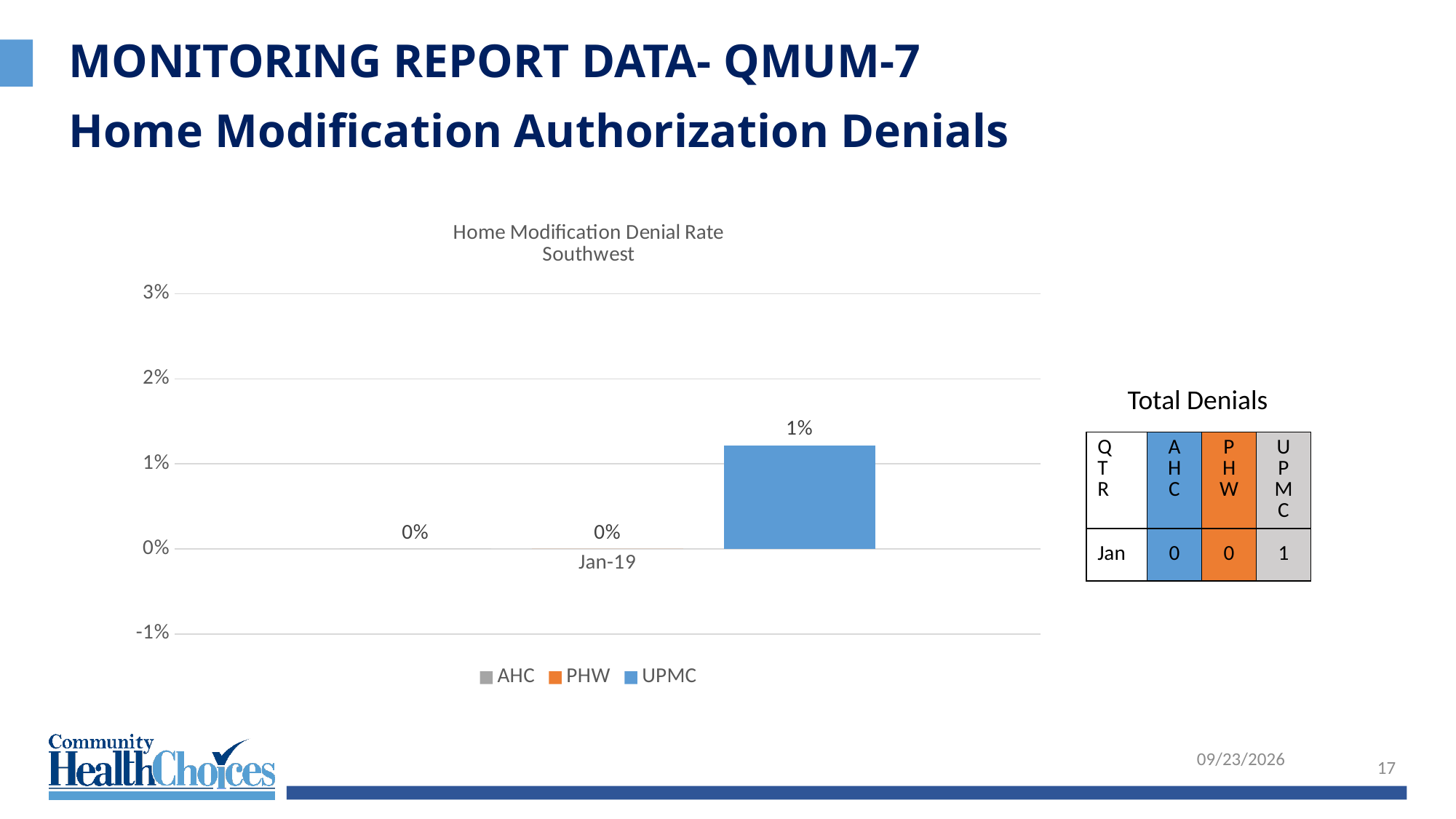
Is the UPMC denial rate for Jan-19 greater or less than 2%? less What is the title of the chart? Home Modification Denial Rate Southwest What is the difference between the UPMC and AHC denial rates in Jan-19? 1% Which series has the highest denial rate in Jan-19? UPMC How many time periods are shown on the x axis? 1 Which series is shown in orange in the legend? PHW Which is larger in Jan-19, the denial rate for UPMC or for PHW? UPMC What is the denial rate for UPMC in Jan-19? 1% What kind of chart is shown on the slide? Bar chart What is the denial rate for PHW in Jan-19? 0% What is the denial rate for AHC in Jan-19? 0% How many series does the legend list? 3